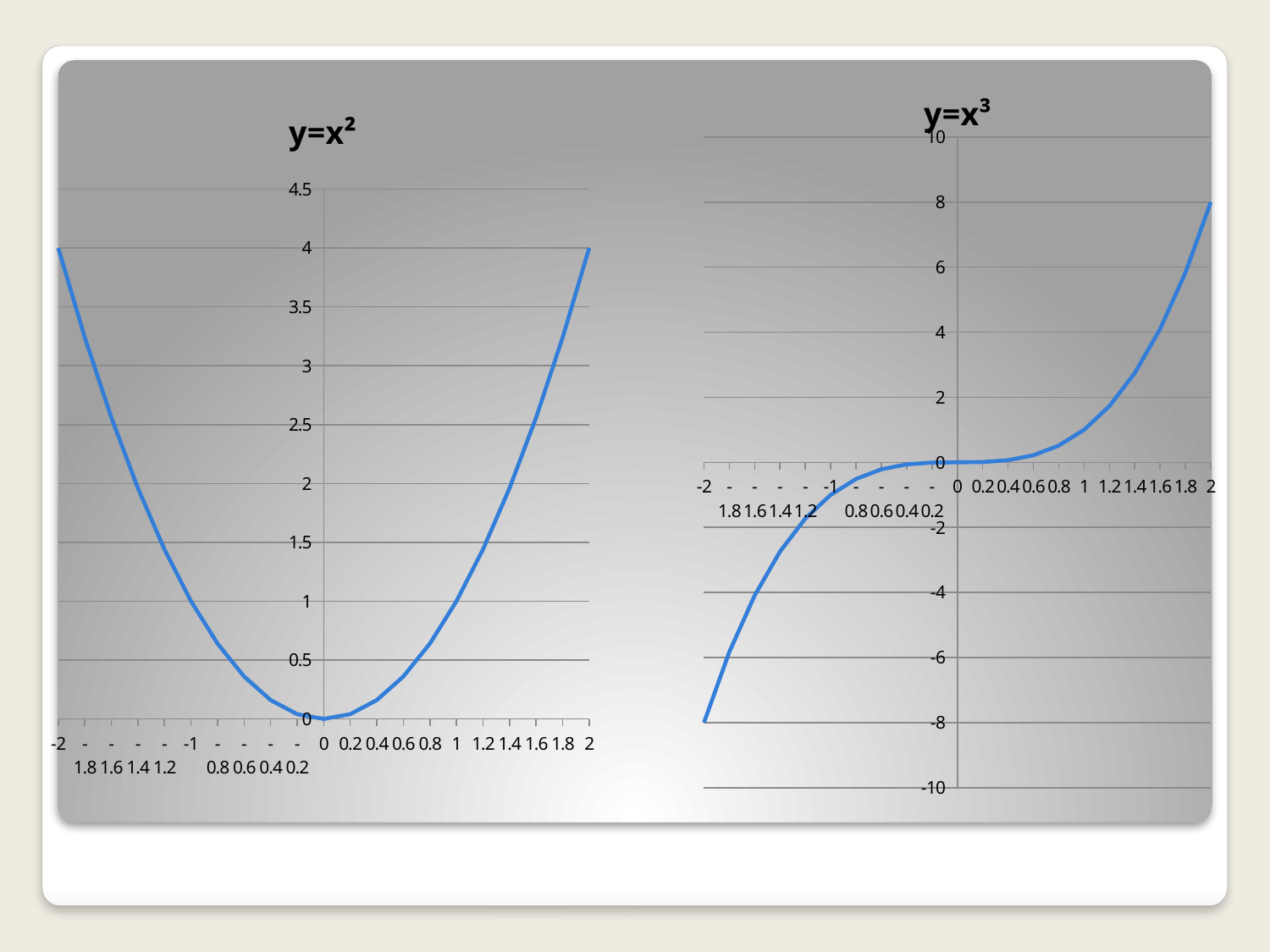
What type of chart is the chart titled y=x³? line chart In the chart titled y=x², what is the value of y at x = 0? 0 In the chart titled y=x³, do the values rise or fall as x increases from -2 to 2? rise In the chart titled y=x², what is the value of y at x = 2? 4 In the chart titled y=x², at which x value is y lowest? 0 In the chart titled y=x³, is the value of y at x = 1.6 greater or less than 2? greater In the chart titled y=x², is the value of y at x = 1.6 greater or less than 3? less What type of chart is the chart titled y=x²? line chart In the chart titled y=x², what is the value of y at x = -2? 4 In the chart titled y=x³, what is the value of y at x = 2? 8 What is the highest value shown on the vertical axis of the chart titled y=x³? 10 In the chart titled y=x³, what is the value of y at x = -2? -8